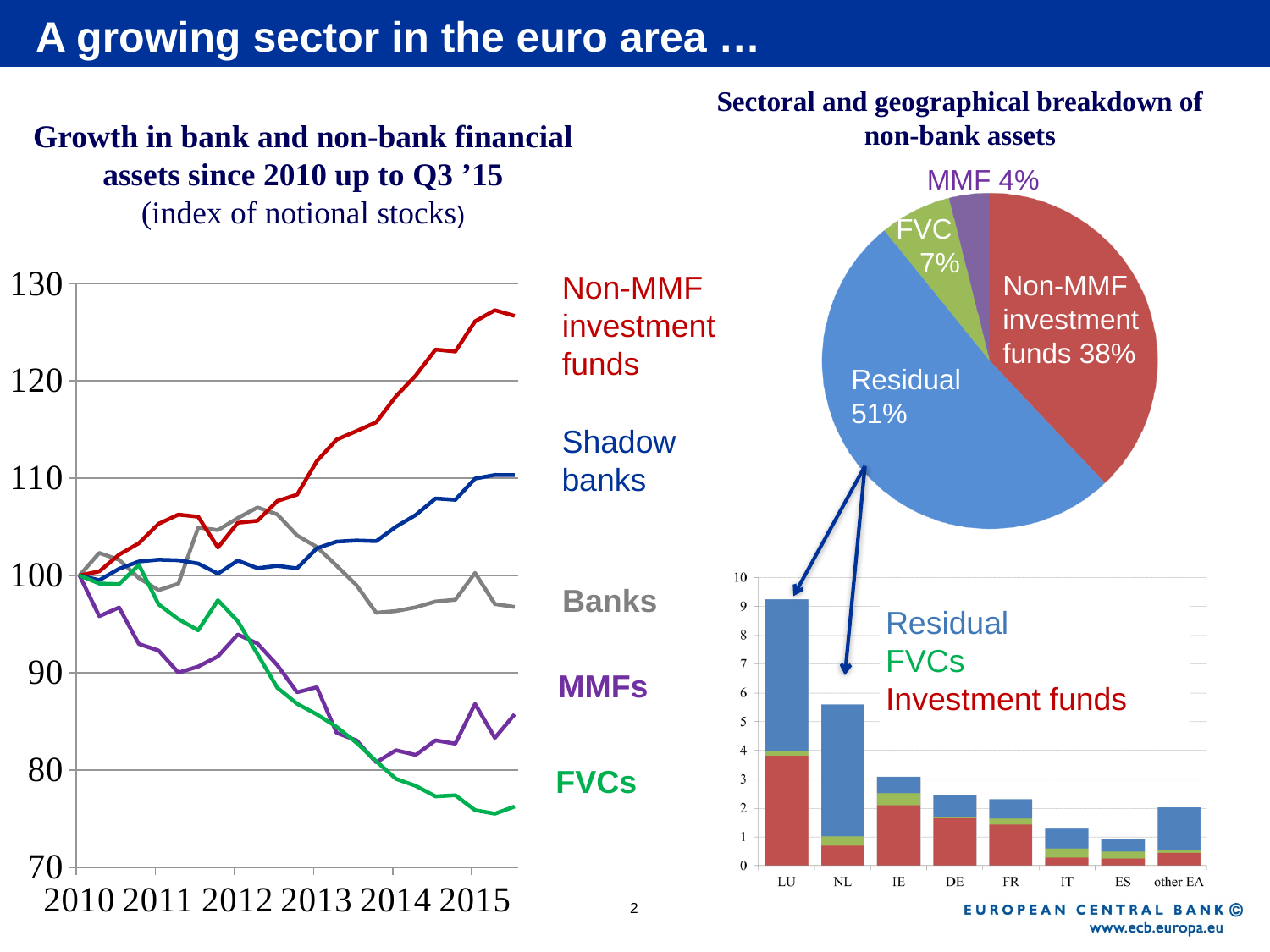
In the stacked bar chart at the bottom right, which country has the tallest bar? LU In the pie chart 'Sectoral and geographical breakdown of non-bank assets', which slice is the smallest? MMF In the line chart 'Growth in bank and non-bank financial assets since 2010 up to Q3 '15', is the value for Non-MMF investment funds at the end of the period greater or less than 120? greater In the line chart 'Growth in bank and non-bank financial assets since 2010 up to Q3 '15', does the Non-MMF investment funds series rise or fall from 2010 to 2015? rise How many slices does the pie chart 'Sectoral and geographical breakdown of non-bank assets' have? 4 In the pie chart 'Sectoral and geographical breakdown of non-bank assets', what is the difference between the FVC share and the MMF share? 3% In the line chart 'Growth in bank and non-bank financial assets since 2010 up to Q3 '15', is the value for FVCs at the end of the period greater or less than 80? less How many categories are shown on the x axis of the stacked bar chart at the bottom right? 8 In the stacked bar chart at the bottom right, is the total for NL greater or less than 5? greater In the pie chart 'Sectoral and geographical breakdown of non-bank assets', what share does the Residual slice have? 51% In the pie chart 'Sectoral and geographical breakdown of non-bank assets', what share do Non-MMF investment funds have? 38% In the line chart 'Growth in bank and non-bank financial assets since 2010 up to Q3 '15', how many series are shown? 5